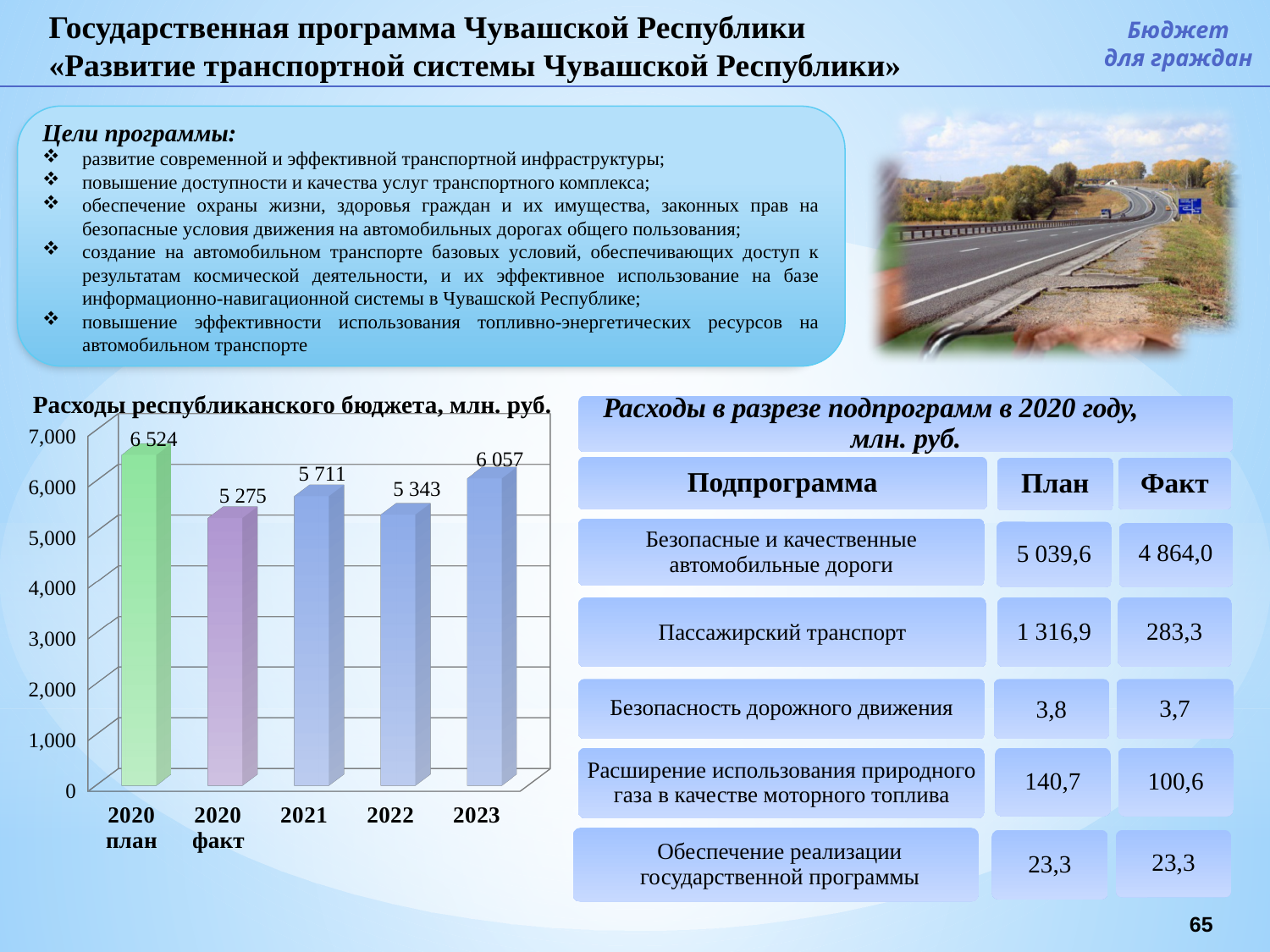
What is the value for 2020 факт in the chart? 5 275 What is the title of the chart on the slide? Расходы республиканского бюджета, млн. руб. Which is larger, the value for 2021 or the value for 2022? 2021 Which category has the lowest value in the chart? 2020 факт What is the value for 2020 план in the chart 'Расходы республиканского бюджета, млн. руб.'? 6 524 What is the value for 2021 in the chart? 5 711 Is the value for 2022 greater or less than 6,000? less Which category has the highest value in the chart? 2020 план What kind of chart is shown on the slide? bar chart What is the value for 2023 in the chart? 6 057 What is the difference between the 2020 план and 2020 факт values? 1 249 How many bars are shown in the chart? 5